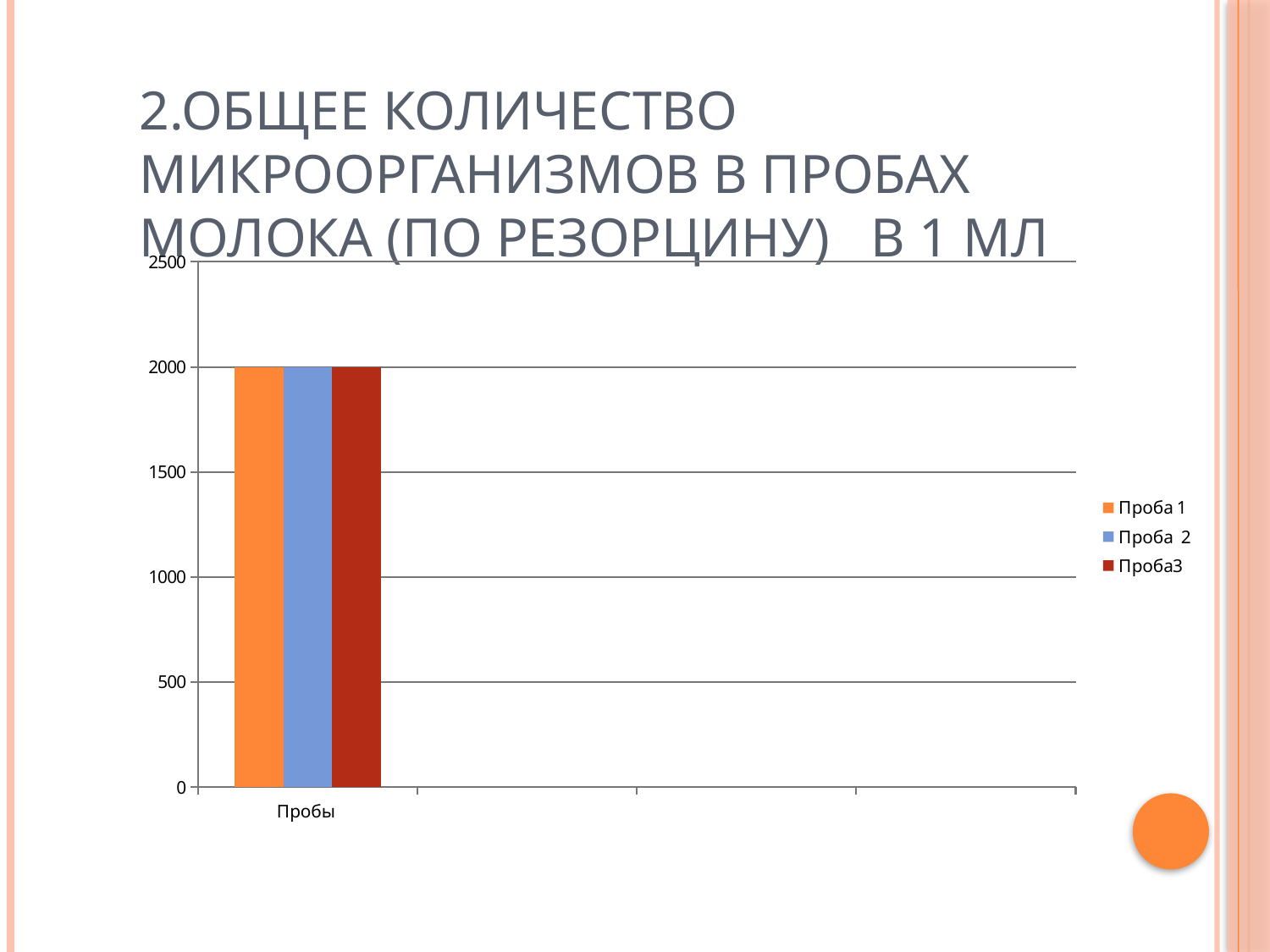
How many series does the legend list? 3 What is the value for Проба 1? 2000 What is the difference between the values for Проба 1 and Проба3? 0 Is the value for Проба 1 greater or less than 1500? greater Is the value for Проба 2 greater or less than 1000? greater What is the value for Проба 2? 2000 What is the value for Проба3? 2000 Is the value for Проба3 greater or less than 2500? less What is the label of the category on the x axis? Пробы How many categories are shown on the x axis? 1 Which series is shown in orange in the legend? Проба 1 What kind of chart is shown on the slide? bar chart